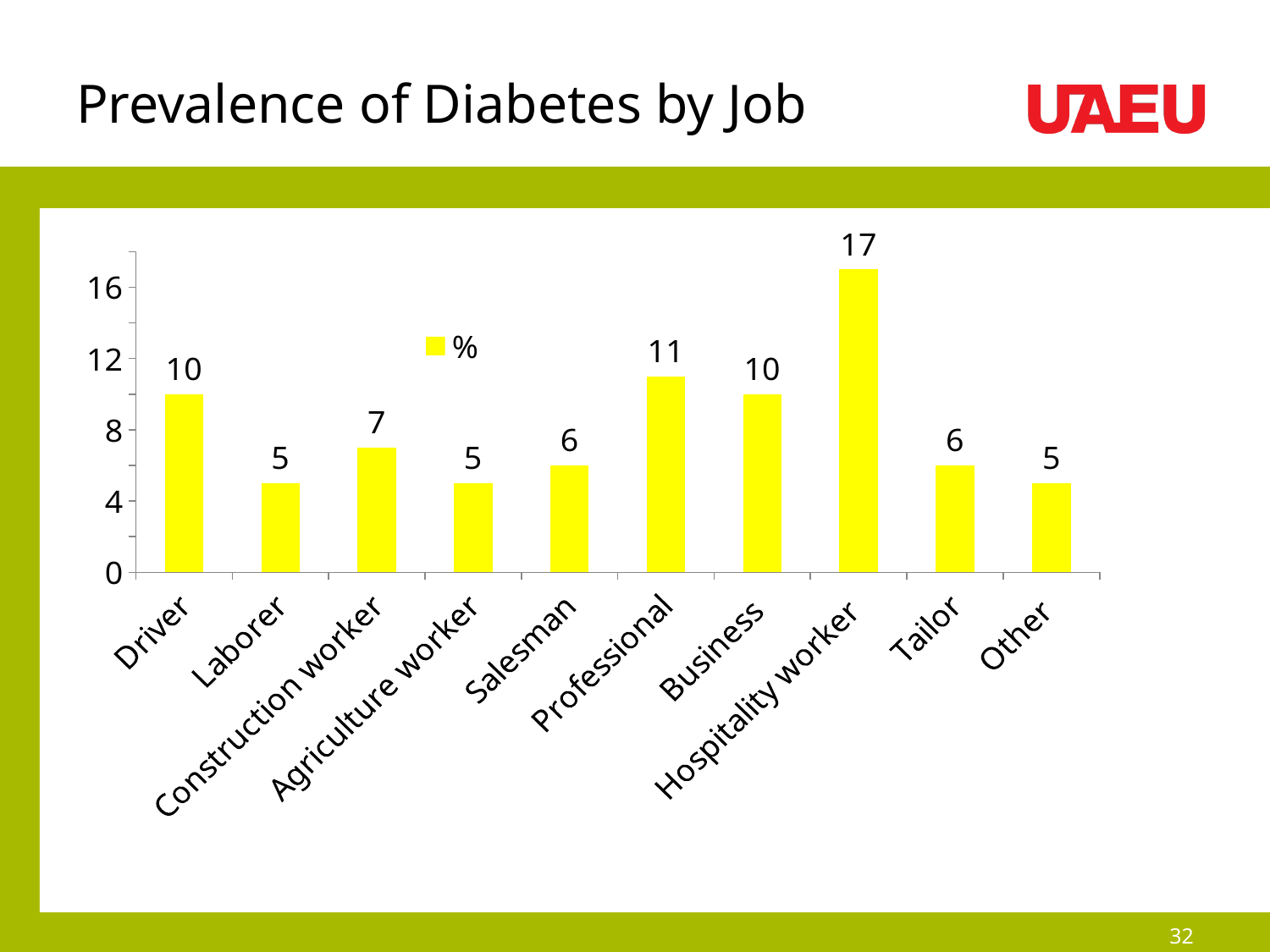
What is the value for Construction worker? 7 What is the difference between the values for Professional and Salesman? 5 Which is larger, the value for Business or the value for Tailor? Business What is the value for Hospitality worker? 17 Is the value for Hospitality worker greater or less than 12? greater Which job has the highest value? Hospitality worker What kind of chart is shown on the slide? Bar chart How many job categories are shown on the x axis? 10 Which is larger, the value for Construction worker or the value for Laborer? Construction worker What is the value for Professional? 11 What is the difference between the values for Hospitality worker and Driver? 7 What is the title of the slide? Prevalence of Diabetes by Job